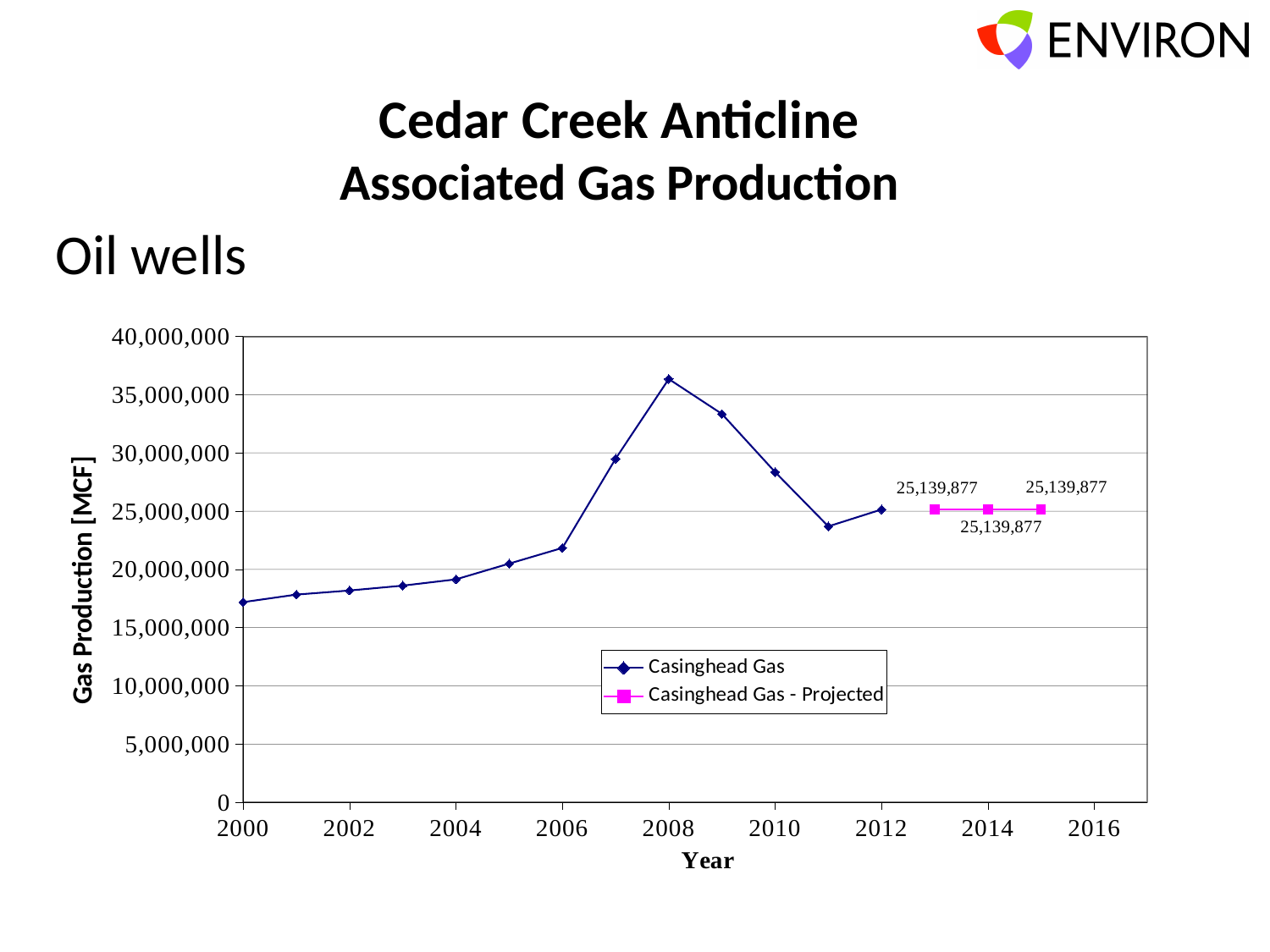
Does Casinghead Gas production rise or fall from 2008 to 2011? Fall Is the Casinghead Gas value for 2008 greater or less than 35,000,000? greater Which year has the larger Casinghead Gas value, 2006 or 2010? 2010 What is the projected Casinghead Gas value for 2013? 25,139,877 Is the Casinghead Gas value for 2011 greater or less than 25,000,000? less What is the projected Casinghead Gas value for 2015? 25,139,877 How many data points are plotted for the Casinghead Gas - Projected series? 3 What type of chart is shown on the slide? Line chart In which year is Casinghead Gas production lowest? 2000 What is the title of the vertical axis? Gas Production [MCF] In which year is Casinghead Gas production highest? 2008 How many series does the legend list? 2